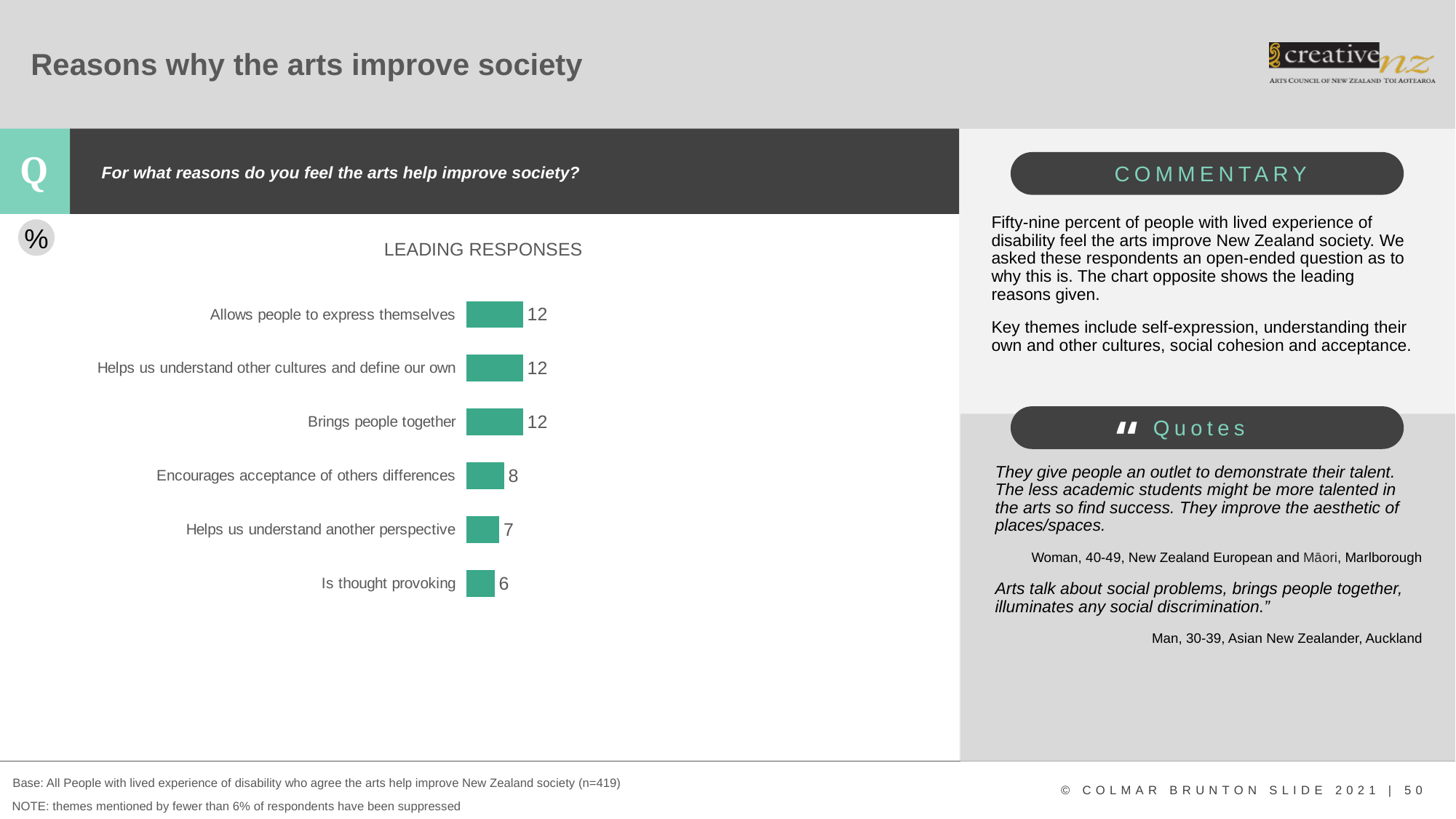
How many categories share the highest value of 12? 3 What is the value for "Encourages acceptance of others differences"? 8 What is the value for "Is thought provoking"? 6 What is the difference between the values for "Brings people together" and "Is thought provoking"? 6 How many categories are shown in the chart? 6 What is the value for "Helps us understand another perspective"? 7 Which is larger: the value for "Helps us understand other cultures and define our own" or the value for "Encourages acceptance of others differences"? Helps us understand other cultures and define our own What is the difference between the values for "Encourages acceptance of others differences" and "Helps us understand another perspective"? 1 What kind of chart is shown on the slide? Bar chart Which category has the lowest value? Is thought provoking What is the value for "Allows people to express themselves"? 12 What is the title of the chart? LEADING RESPONSES